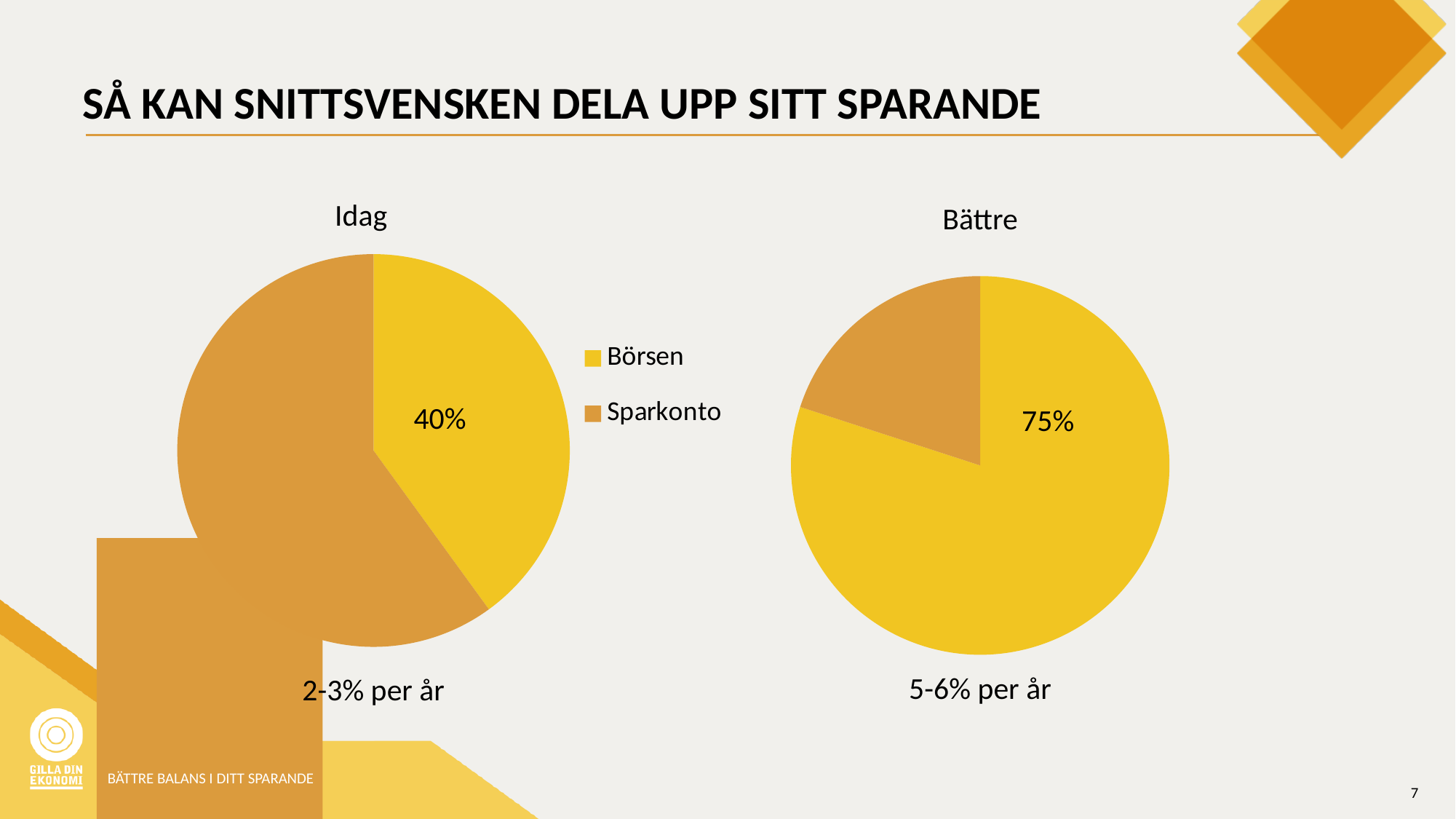
In the "Idag" pie chart, which slice is larger, Börsen or Sparkonto? Sparkonto What text is printed below the "Bättre" pie chart? 5-6% per år How many entries does the legend list for the pie charts? 2 In the "Bättre" pie chart, which category has the smallest slice? Sparkonto How many slices does the "Idag" pie chart have? 2 What share of the "Idag" pie does the Börsen slice represent? 40% In the "Idag" pie chart, what share is labelled for Börsen? 40% By how many percentage points is the Börsen share in the "Bättre" chart higher than in the "Idag" chart? 35 percentage points In the "Bättre" pie chart, what share is labelled for Börsen? 75% In the "Bättre" pie chart, which slice is larger, Börsen or Sparkonto? Börsen What kind of chart is used for "Idag" and "Bättre"? Pie chart Which legend entry is shown in yellow? Börsen